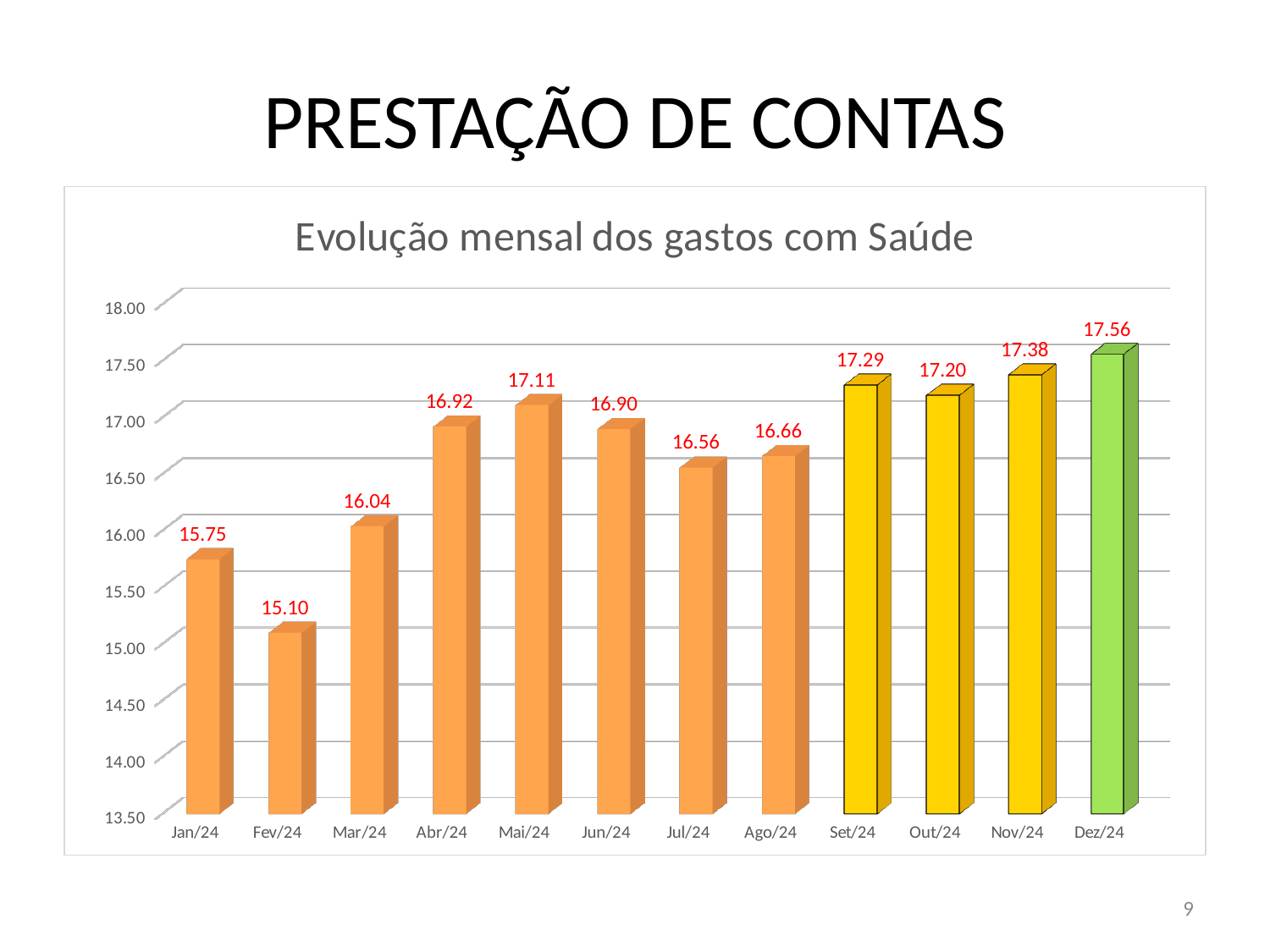
Which month has the lowest value? Fev/24 Do the values generally rise or fall from Jan/24 to Dez/24? rise Is the value for Abr/24 greater or less than 17.00? less Which month has the highest value? Dez/24 What is the value for Jan/24? 15.75 What kind of chart is this? bar chart How many months are shown on the x axis? 12 What is the title of the chart? Evolução mensal dos gastos com Saúde What is the value for Mai/24? 17.11 What is the difference between the values for Dez/24 and Jan/24? 1.81 Which is larger, the value for Set/24 or the value for Out/24? Set/24 What is the value for Dez/24? 17.56